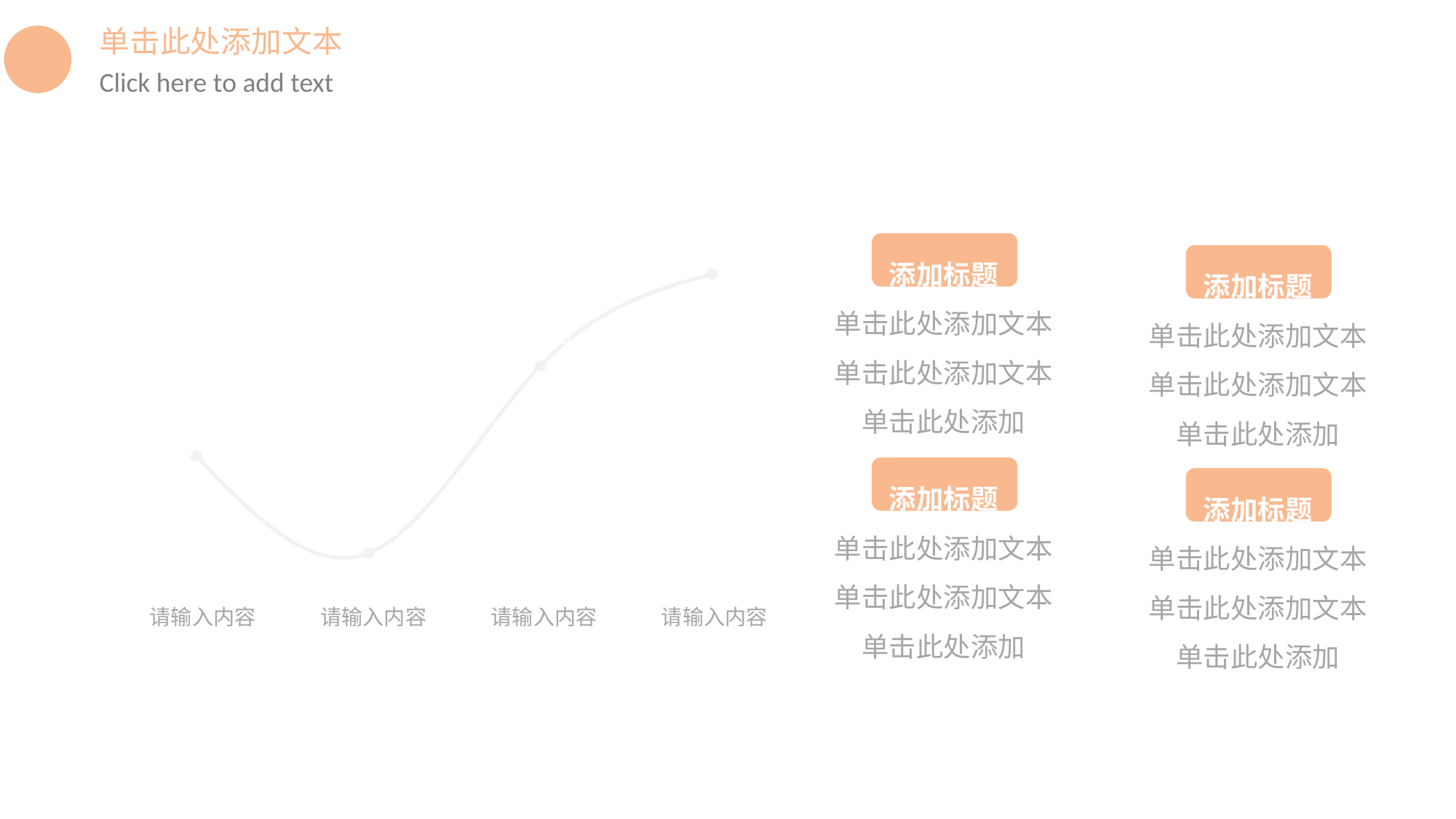
How many category labels appear along the x axis of the line chart? 4 On the line chart, is the third point higher or lower than the second point? higher What placeholder text is used for each category label on the x axis of the line chart? 请输入内容 Does the line on the chart rise or fall between the second and fourth points? rise Does the line on the chart rise or fall between the first and second points? fall On the line chart, is the last (rightmost) point higher or lower than the first point? higher Which data point on the line chart is the lowest? the second point On the line chart, is the first (leftmost) point higher or lower than the second point? higher Which data point on the line chart is the highest? the fourth (rightmost) point How many data points are plotted on the line chart? 4 What kind of chart is shown on the left of the slide? line chart Does the line chart display a legend? No